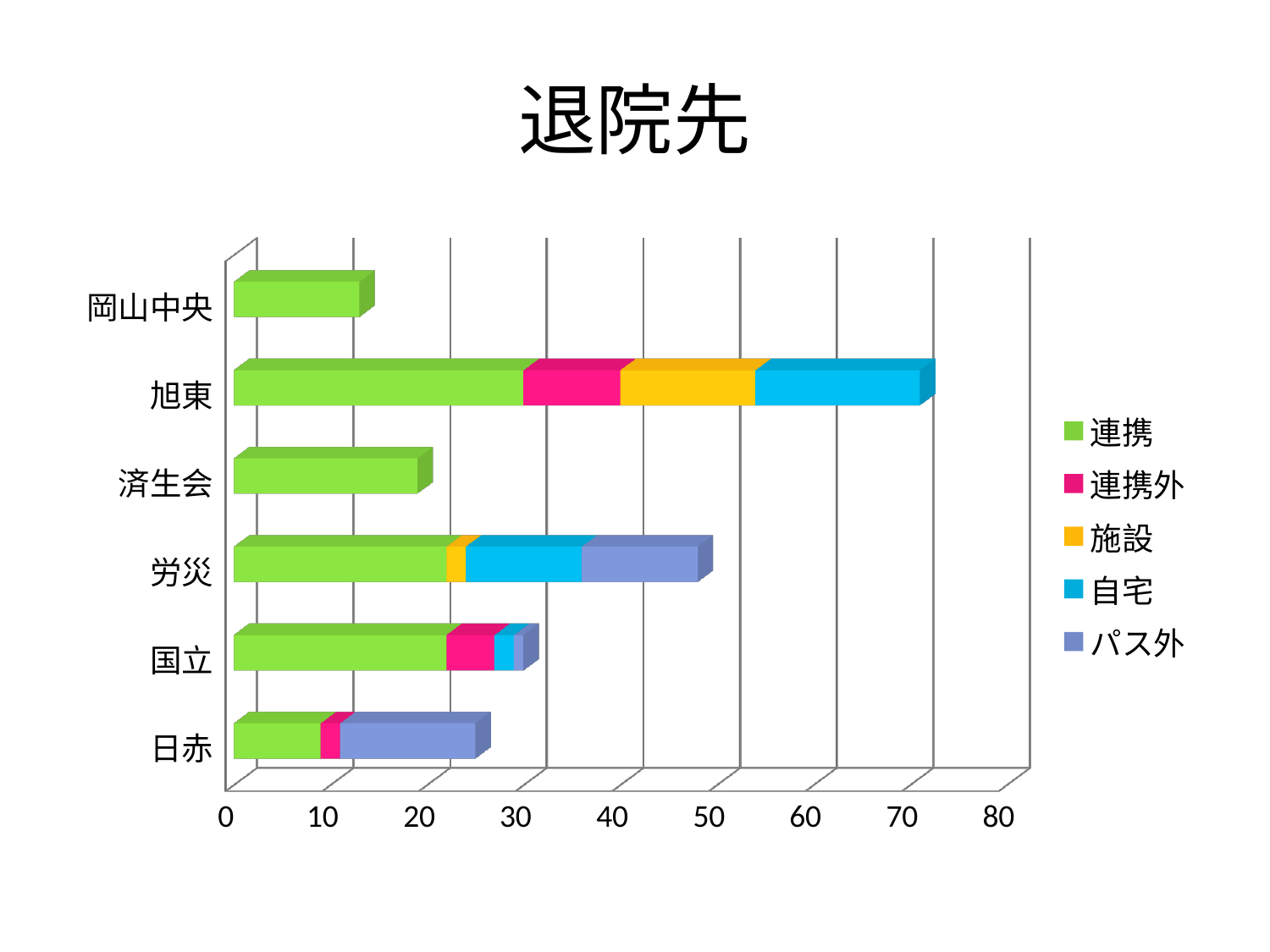
Is the total bar for 労災 greater or less than 40? greater How many categories (hospitals) are shown on the chart? 6 Is the total bar for 岡山中央 greater or less than 20? less Which series is shown in green in the legend? 連携 Which category has the longest total bar? 旭東 Which has the longer total bar, 日赤 or 旭東? 旭東 Which has the longer total bar, 済生会 or 労災? 労災 What is the title of the chart? 退院先 How many series does the legend list? 5 What kind of chart is shown on the slide? stacked bar chart Is the total bar for 旭東 greater or less than 60? greater Which category has the shortest total bar? 岡山中央